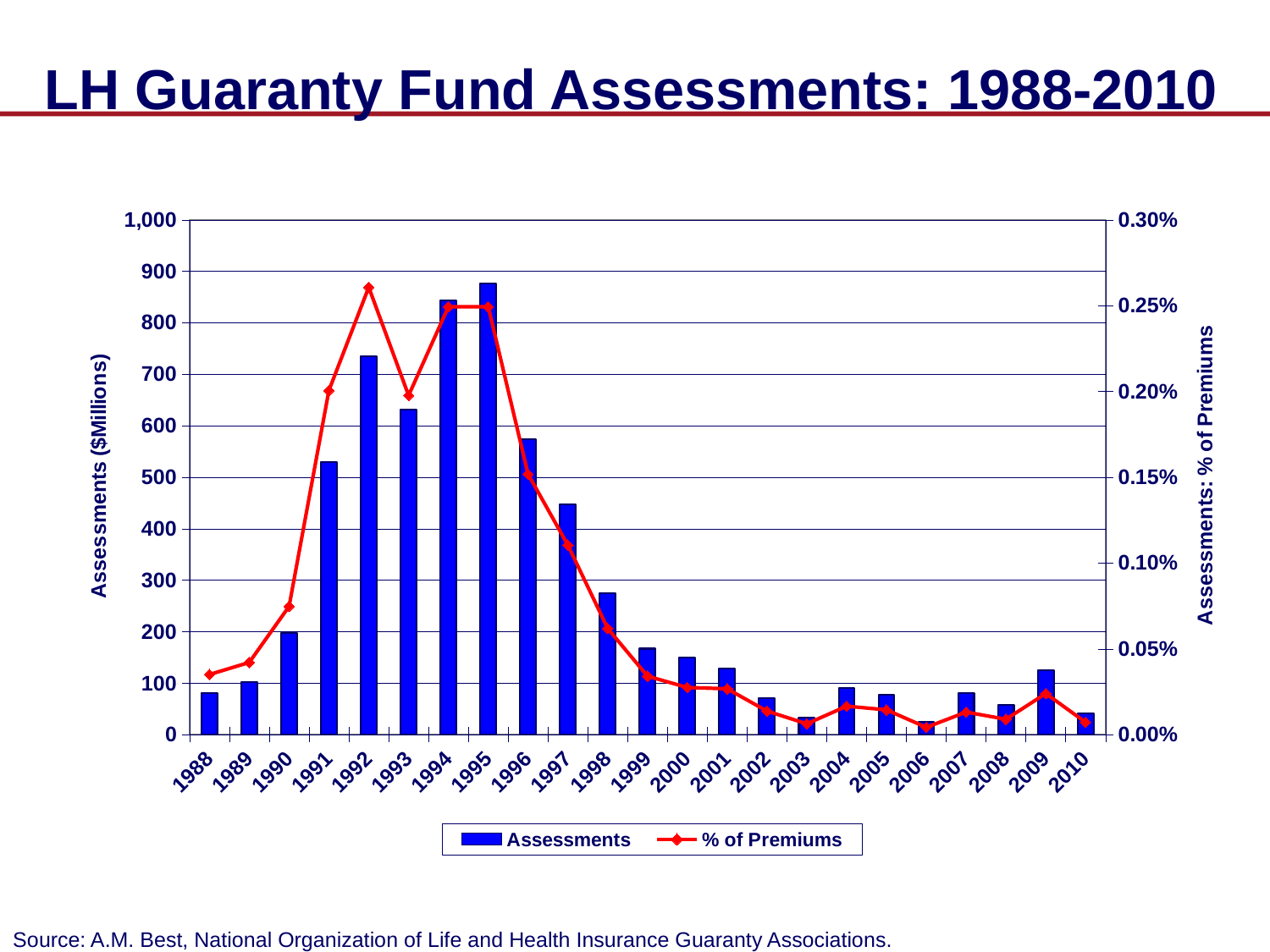
Which year has the highest Assessments bar? 1995 Is the Assessments value for 1991 greater or less than 500? greater Which year has the larger Assessments bar, 1992 or 1993? 1992 How many series does the legend list? 2 What is the label of the left vertical axis? Assessments ($Millions) Is the Assessments value for 1992 greater or less than 700? greater Is the % of Premiums value for 1990 greater or less than 0.05%? greater What kind of chart is shown on the slide? A combined bar and line chart Do the Assessments bars generally rise or fall from 1995 to 2003? fall How many years are shown on the x axis? 23